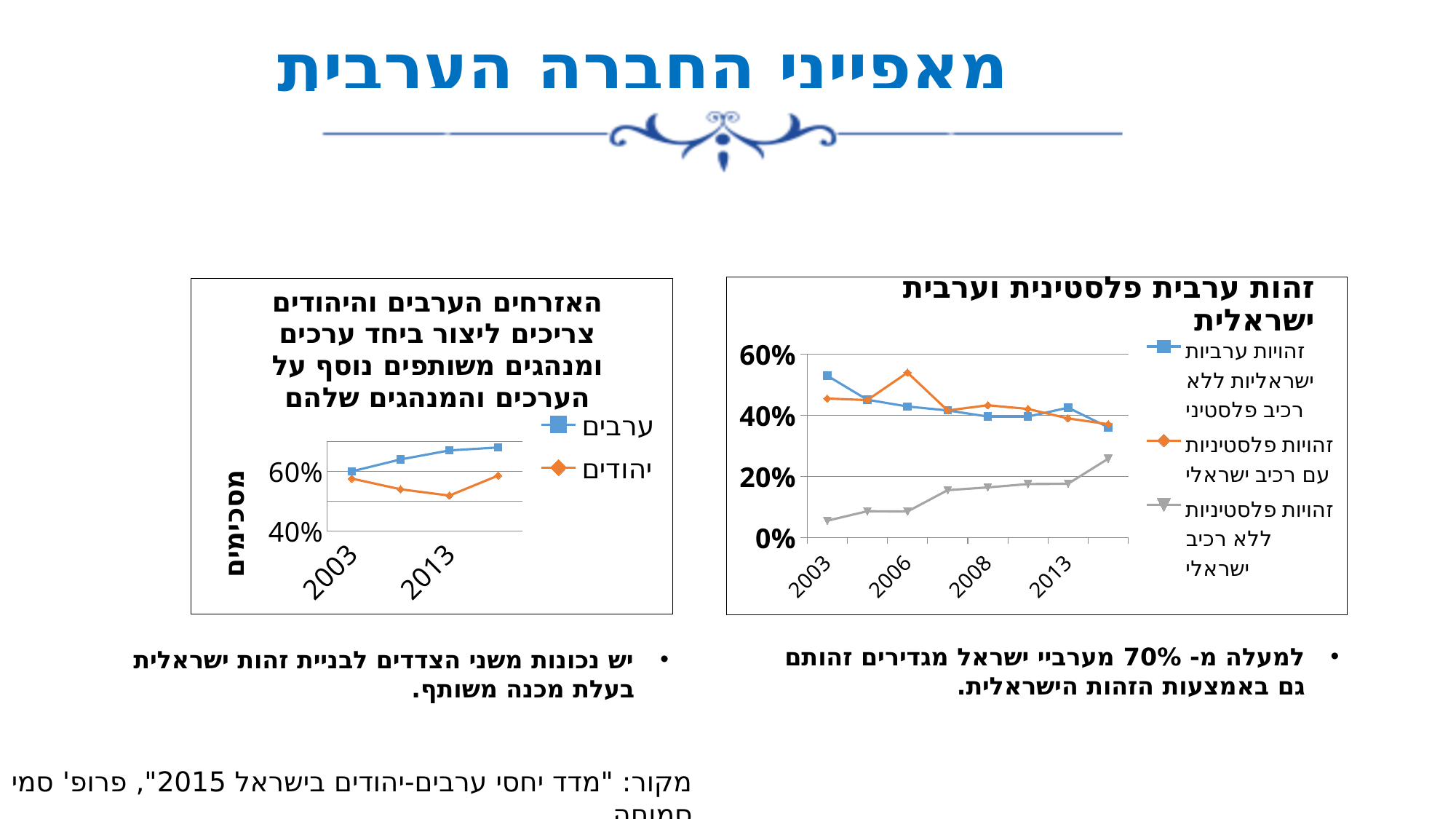
In the left chart ("האזרחים הערבים והיהודים..."), is the value for ערבים in 2013 greater or less than 60%? greater How many year labels are shown on the x axis of the chart titled "זהות ערבית פלסטינית וערבית ישראלית"? 4 In the chart titled "זהות ערבית פלסטינית וערבית ישראלית", which series has the highest value in 2003? זהויות ערביות ישראליות ללא רכיב פלסטיני How many series does the legend of the chart titled "זהות ערבית פלסטינית וערבית ישראלית" list? 3 In the chart titled "זהות ערבית פלסטינית וערבית ישראלית", does the series "זהויות ערביות ישראליות ללא רכיב פלסטיני" rise or fall over time? fall How many series does the legend of the left chart ("האזרחים הערבים והיהודים...") list? 2 In the chart titled "זהות ערבית פלסטינית וערבית ישראלית", is the value for "זהויות פלסטיניות ללא רכיב ישראלי" in 2003 greater or less than 20%? less In the left chart ("האזרחים הערבים והיהודים..."), which series is higher in 2013, ערבים or יהודים? ערבים What kind of chart is the chart titled "זהות ערבית פלסטינית וערבית ישראלית"? line chart In the chart titled "זהות ערבית פלסטינית וערבית ישראלית", does the series "זהויות פלסטיניות ללא רכיב ישראלי" rise or fall over time? rise In the chart titled "זהות ערבית פלסטינית וערבית ישראלית", is the value for "זהויות ערביות ישראליות ללא רכיב פלסטיני" in 2003 greater or less than 40%? greater In the chart titled "זהות ערבית פלסטינית וערבית ישראלית", which series has the lowest value in 2003? זהויות פלסטיניות ללא רכיב ישראלי